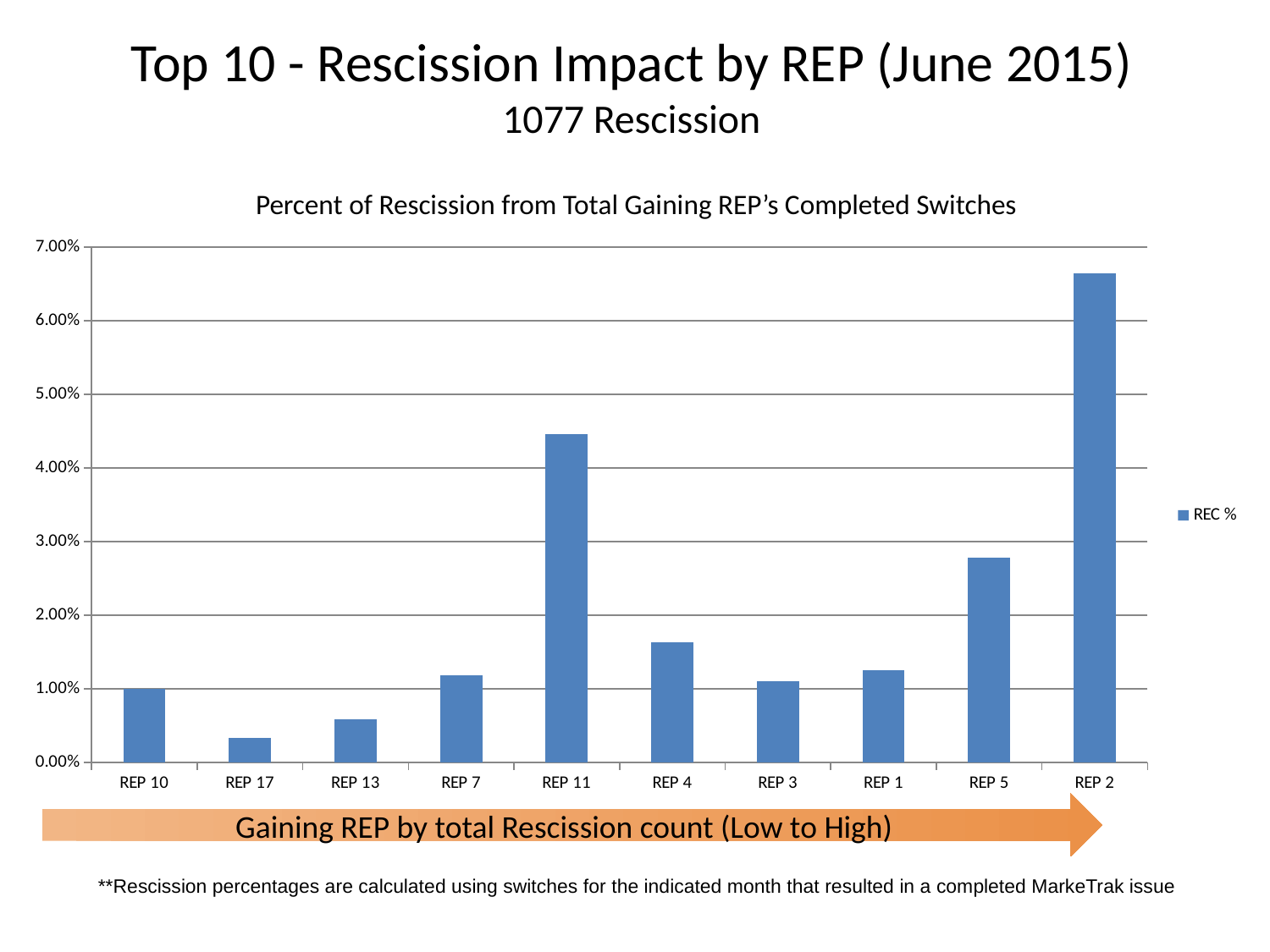
Which has a higher rescission percentage, REP 11 or REP 5? REP 11 How many REPs are plotted on the chart? 10 What kind of chart is shown on the slide? Bar chart Is the value for REP 11 greater or less than 4.00%? greater Is the value for REP 13 greater or less than 1.00%? less Which REP has the highest rescission percentage? REP 2 Which REP has the lowest rescission percentage? REP 17 Which has a higher rescission percentage, REP 4 or REP 3? REP 4 What is the name of the series shown in the legend? REC % Is the value for REP 2 greater or less than 6.00%? greater How many series does the legend list? 1